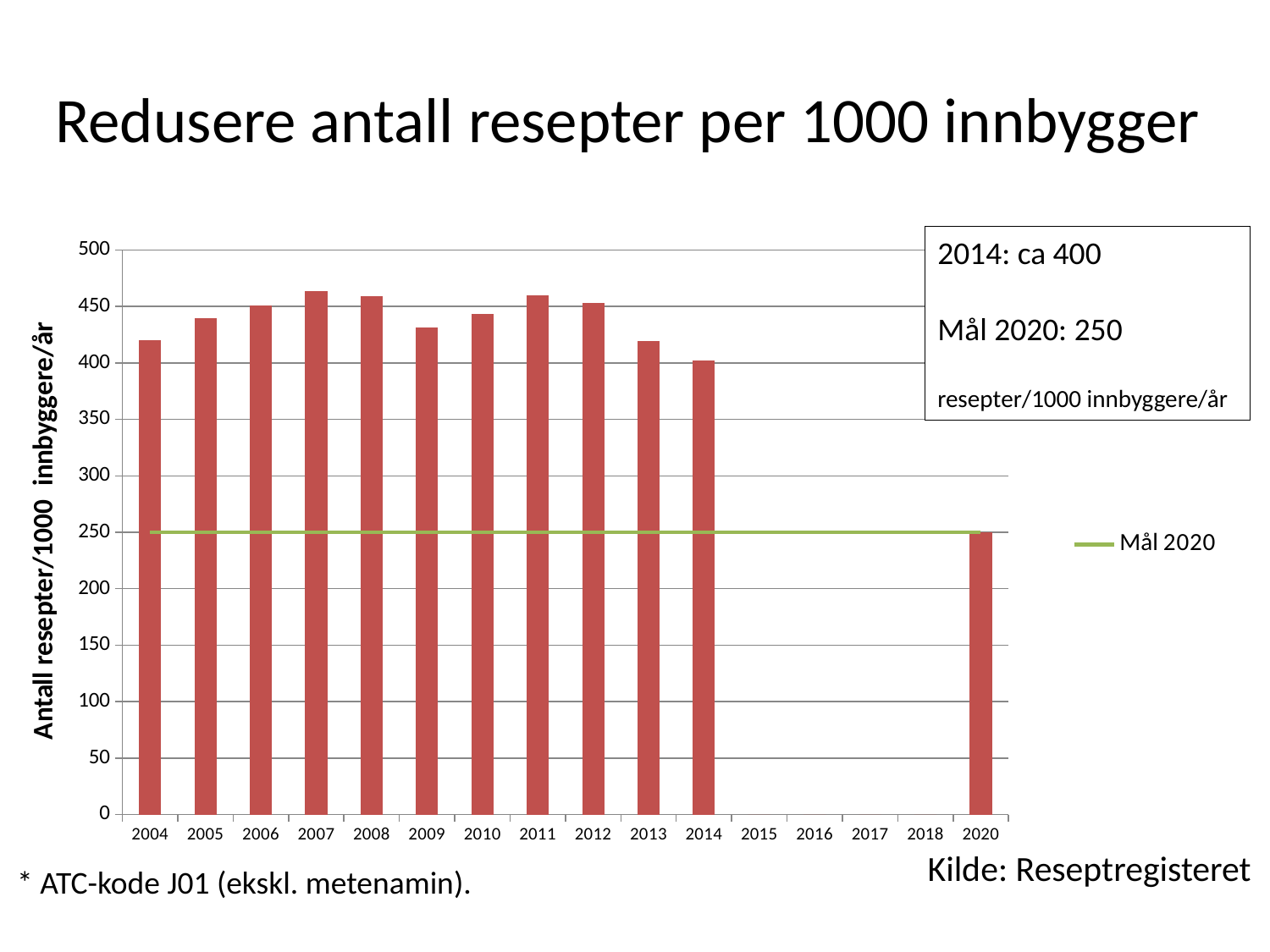
Among the years 2004 to 2014, which year has the lowest bar? 2014 Is the value for 2007 greater or less than 450? greater Is the value for 2009 greater or less than 450? less Which year has the lowest bar in the chart? 2020 What is the title of the vertical axis? Antall resepter/1000 innbyggere/år How many bars are plotted in the chart? 12 What type of chart is shown on the slide? combination bar and line chart Do the values rise or fall from 2011 to 2014? fall What value does the bar for 2020 reach? 250 Which is larger, the value for 2007 or the value for 2009? 2007 How many entries does the legend list? 1 At what value is the horizontal 'Mål 2020' line drawn? 250